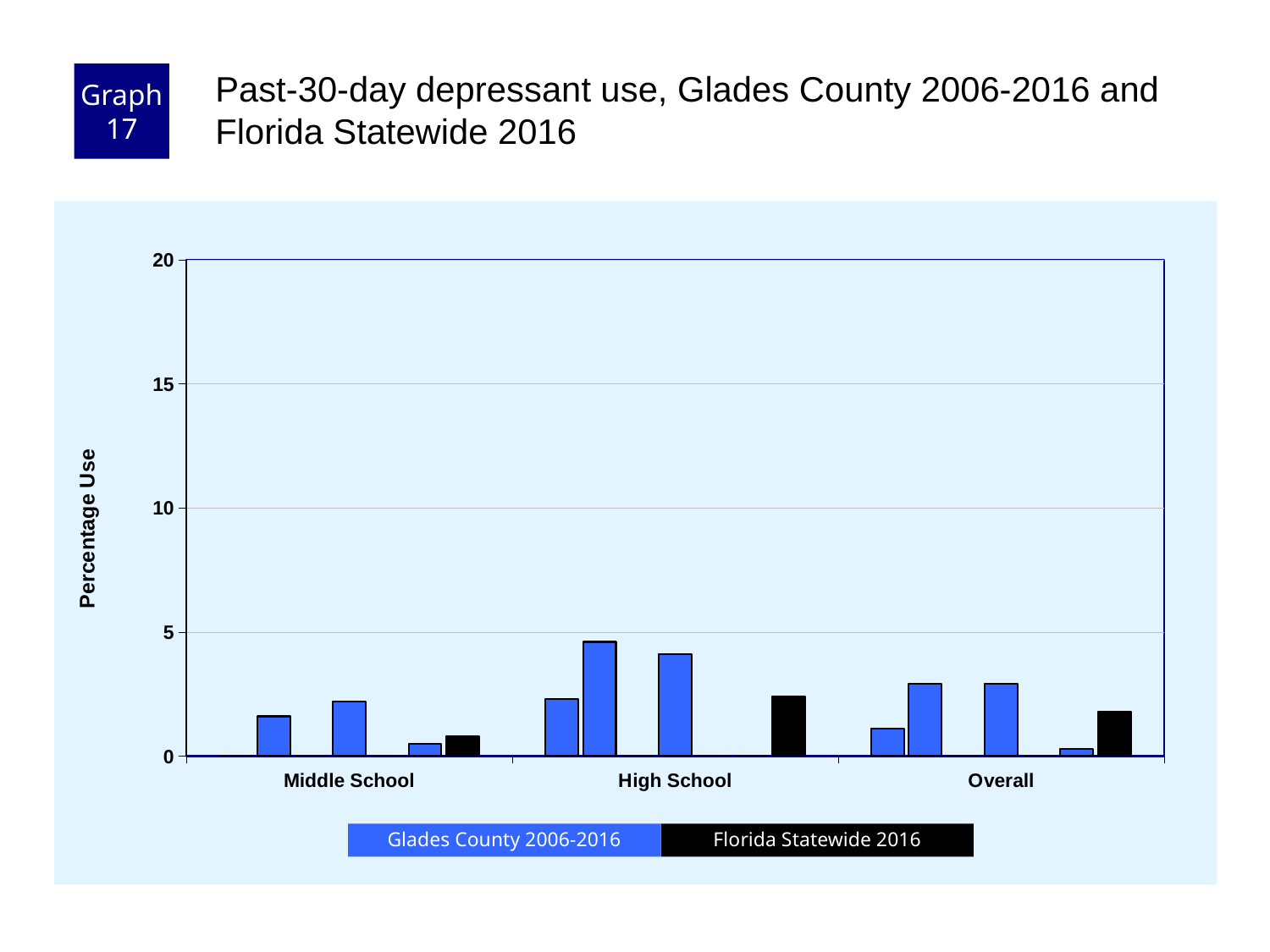
Is the Florida Statewide 2016 value for High School greater or less than 5? less Which is larger: the Florida Statewide 2016 value for High School or for Middle School? High School What colour represents Florida Statewide 2016 in the legend? black How many series does the legend list? 2 How many categories are shown on the x axis? 3 Are any of the bars in the chart greater than 10? No What kind of chart is shown on the slide? bar chart What is the label on the y axis? Percentage Use Which category has the highest Florida Statewide 2016 value? High School Which is larger: the Florida Statewide 2016 value for Overall or for Middle School? Overall Is the Florida Statewide 2016 value for Middle School greater or less than 5? less Which category has the lowest Florida Statewide 2016 value? Middle School